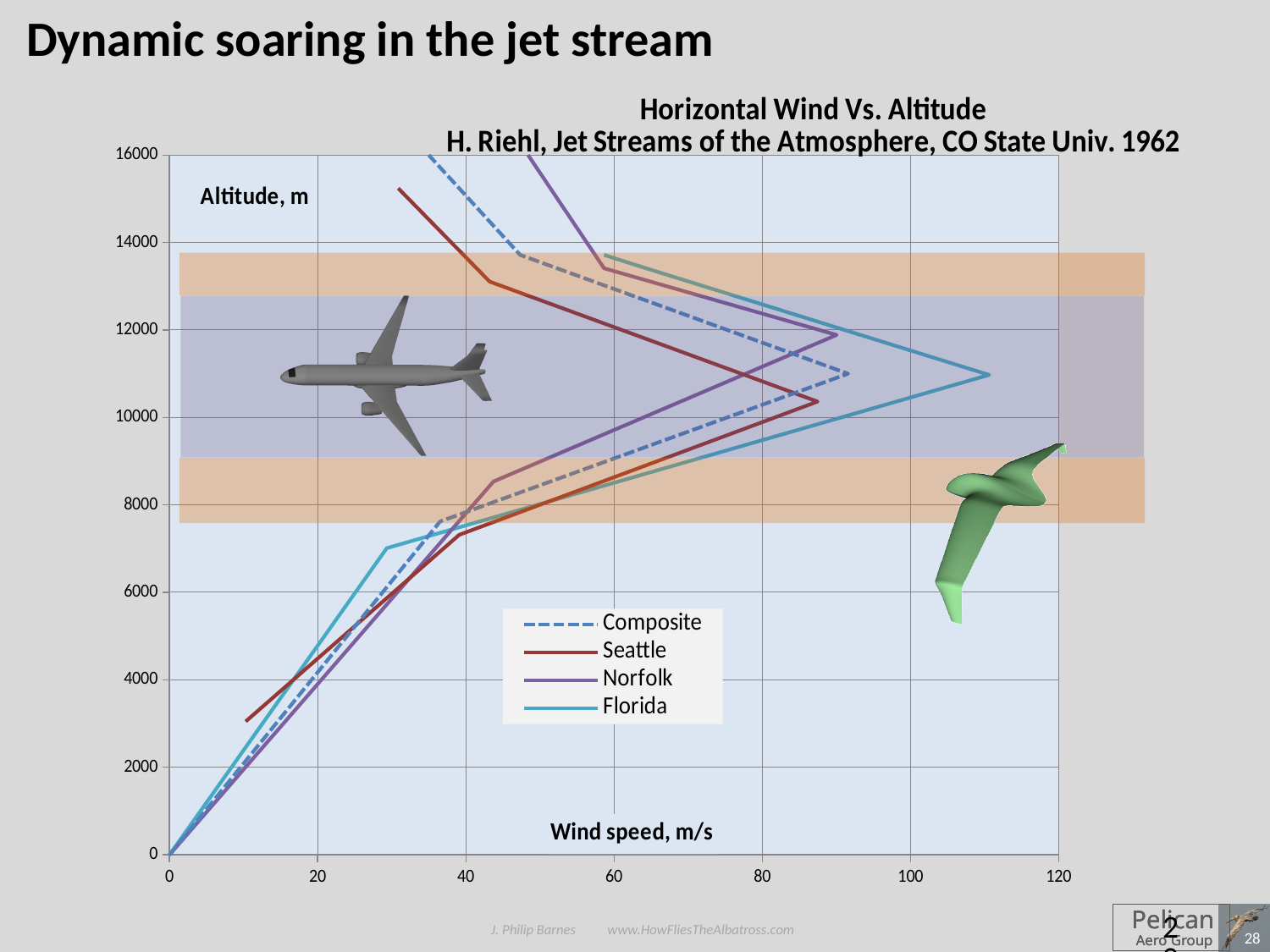
For the Florida series, does wind speed rise or fall as altitude increases from 0 to 8000 m? rise Is the peak wind speed of the Composite series greater or less than 80 m/s? greater Is the peak wind speed of the Seattle series greater or less than 100 m/s? less What are the four series named in the legend? Composite, Seattle, Norfolk, Florida Which series reaches its peak wind speed at a higher altitude, Norfolk or Seattle? Norfolk What kind of chart is shown on the slide? line chart Which series reaches the highest peak wind speed? Florida How many series does the legend list? 4 What is the title of the chart? Horizontal Wind Vs. Altitude H. Riehl, Jet Streams of the Atmosphere, CO State Univ. 1962 Is the peak wind speed of the Norfolk series greater or less than 80 m/s? greater Which has the larger peak wind speed, the Florida series or the Seattle series? Florida